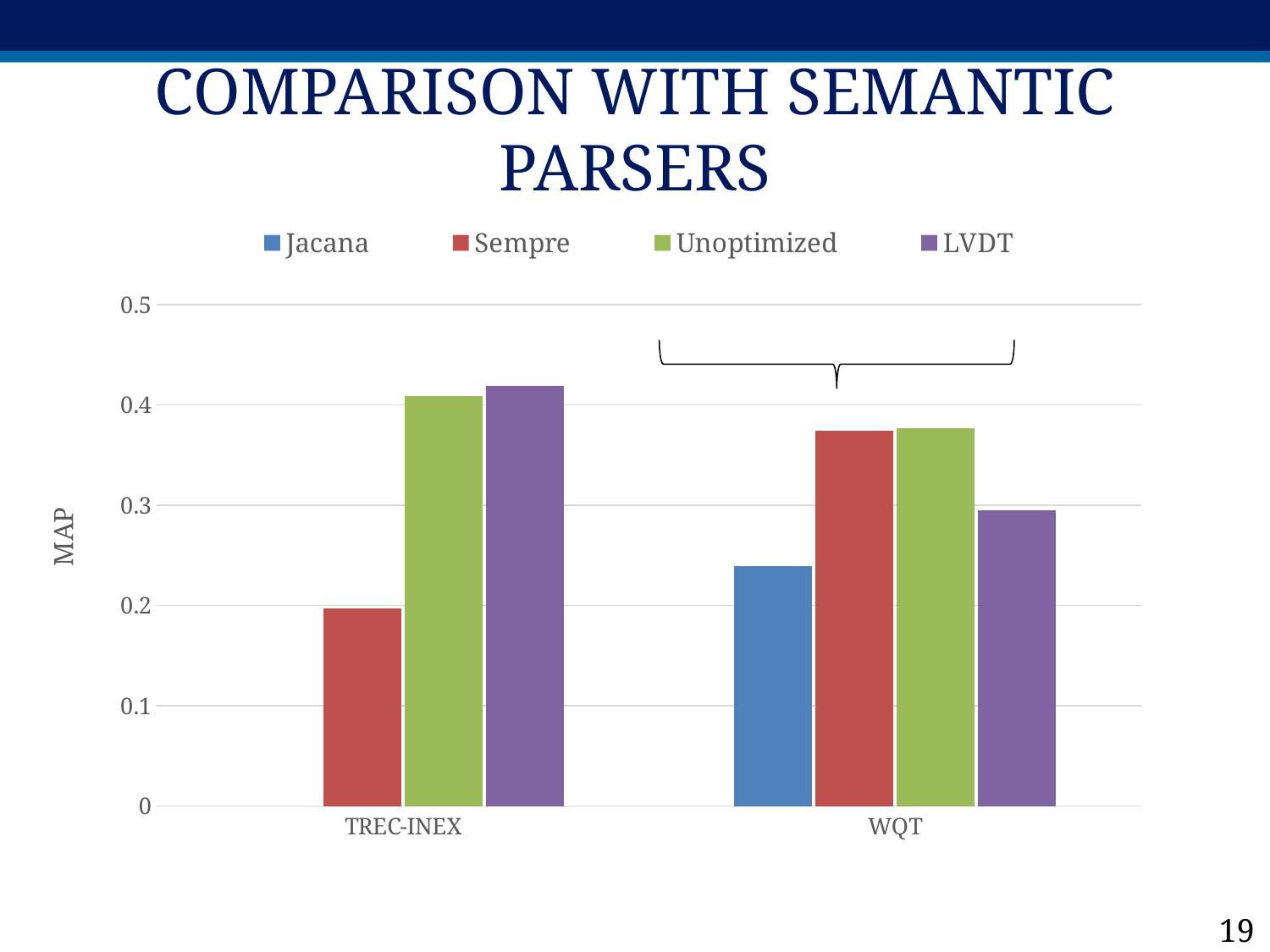
Is the value for Sempre on TREC-INEX greater or less than 0.3? less Which is larger, the LVDT value for TREC-INEX or the LVDT value for WQT? TREC-INEX How many series does the legend list? 4 Is the value for Jacana on WQT greater or less than 0.3? less Which series is shown in purple in the legend? LVDT What kind of chart is shown on the slide? bar chart How many categories are shown on the x axis? 2 Which series has the lowest value for TREC-INEX? Sempre Which is larger, the Sempre value for TREC-INEX or the Sempre value for WQT? WQT Is the value for Sempre on WQT greater or less than 0.3? greater What is the label of the y axis? MAP Which series has the lowest value for WQT? Jacana